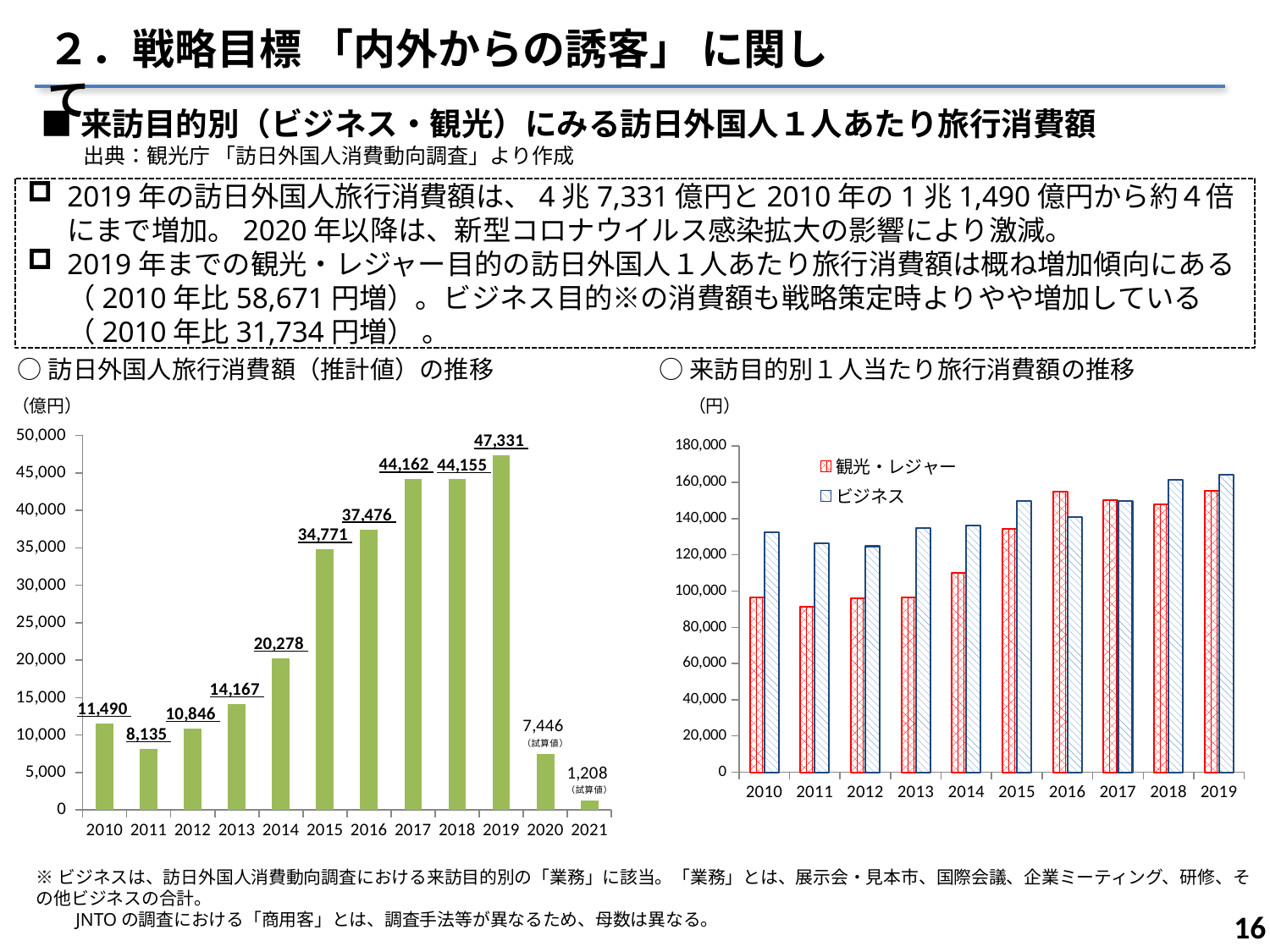
What kind of chart is the right chart (来訪目的別1人当たり旅行消費額の推移)? Bar chart In the left chart (訪日外国人旅行消費額（推計値）の推移), which is larger, the value for 2017 or the value for 2018? 2017 In the left chart (訪日外国人旅行消費額（推計値）の推移), which year has the lowest value? 2021 In the left chart (訪日外国人旅行消費額（推計値）の推移), what is the value for 2019? 47,331 In the left chart (訪日外国人旅行消費額（推計値）の推移), what is the value for 2021? 1,208 How many series does the legend of the right chart (来訪目的別1人当たり旅行消費額の推移) list? 2 In the right chart (来訪目的別1人当たり旅行消費額の推移), is the value for 観光・レジャー in 2010 greater or less than 100,000? less In the left chart (訪日外国人旅行消費額（推計値）の推移), what is the value for 2010? 11,490 In the left chart (訪日外国人旅行消費額（推計値）の推移), which year has the highest value? 2019 How many years are shown on the x axis of the left chart (訪日外国人旅行消費額（推計値）の推移)? 12 In the left chart (訪日外国人旅行消費額（推計値）の推移), what is the difference between the 2019 value and the 2010 value? 35,841 In the right chart (来訪目的別1人当たり旅行消費額の推移), which series is larger in 2019, 観光・レジャー or ビジネス? ビジネス